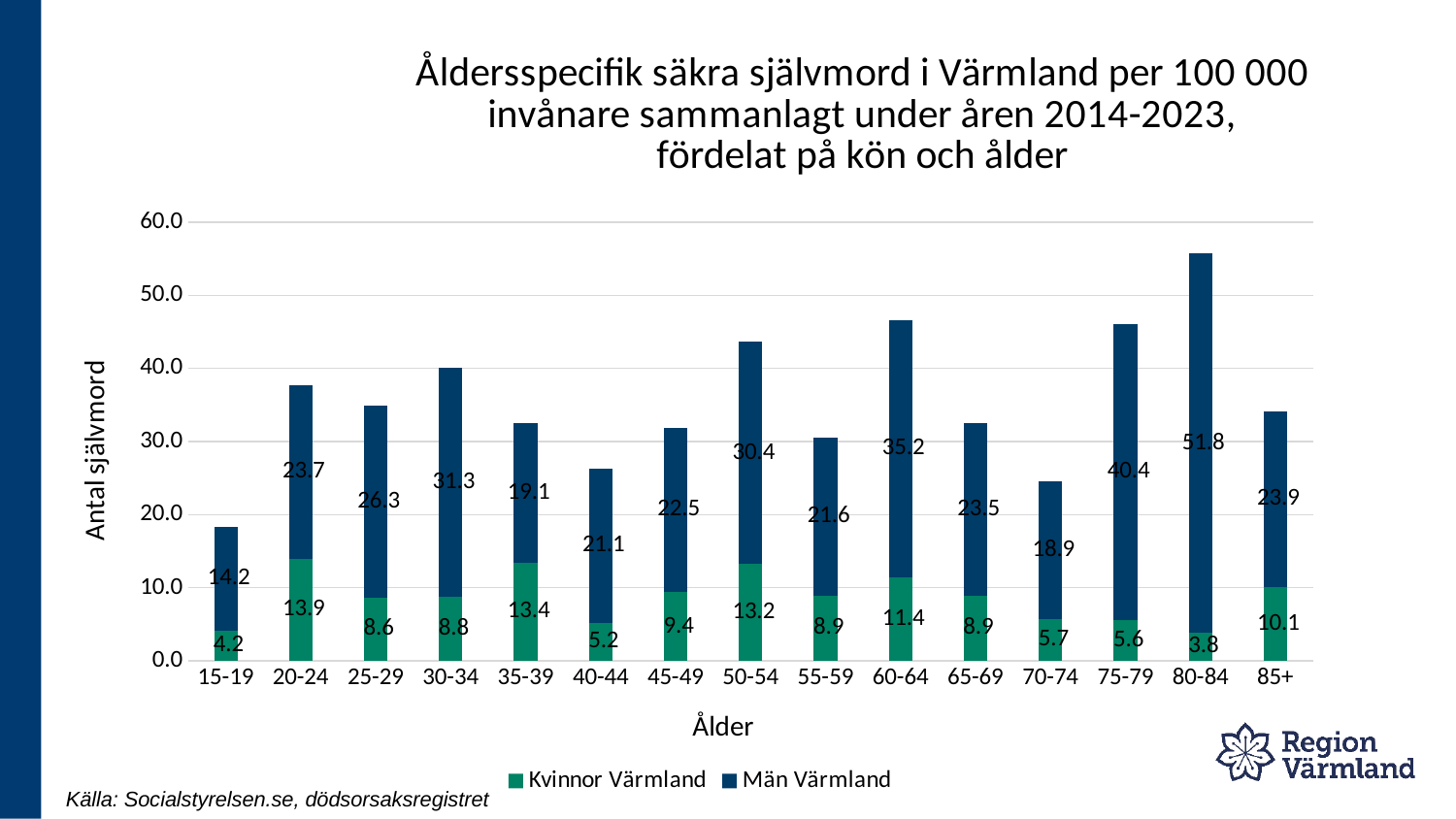
Which age group has the highest value for Män Värmland? 80-84 What kind of chart is shown on the slide? Stacked bar chart What is the value for Män Värmland in the 80-84 age group? 51.8 Which age group has the lowest value for Kvinnor Värmland? 80-84 Which age group has the lowest value for Män Värmland? 15-19 What is the difference between the Män Värmland and Kvinnor Värmland values in the 80-84 age group? 48.0 How many age groups are shown on the x axis? 15 What is the value for Kvinnor Värmland in the 20-24 age group? 13.9 Which is larger: the Män Värmland value for 60-64 or for 75-79? 75-79 What is the value for Kvinnor Värmland in the 40-44 age group? 5.2 What is the total of the stacked bar for the 80-84 age group? 55.6 How many series does the legend list? 2